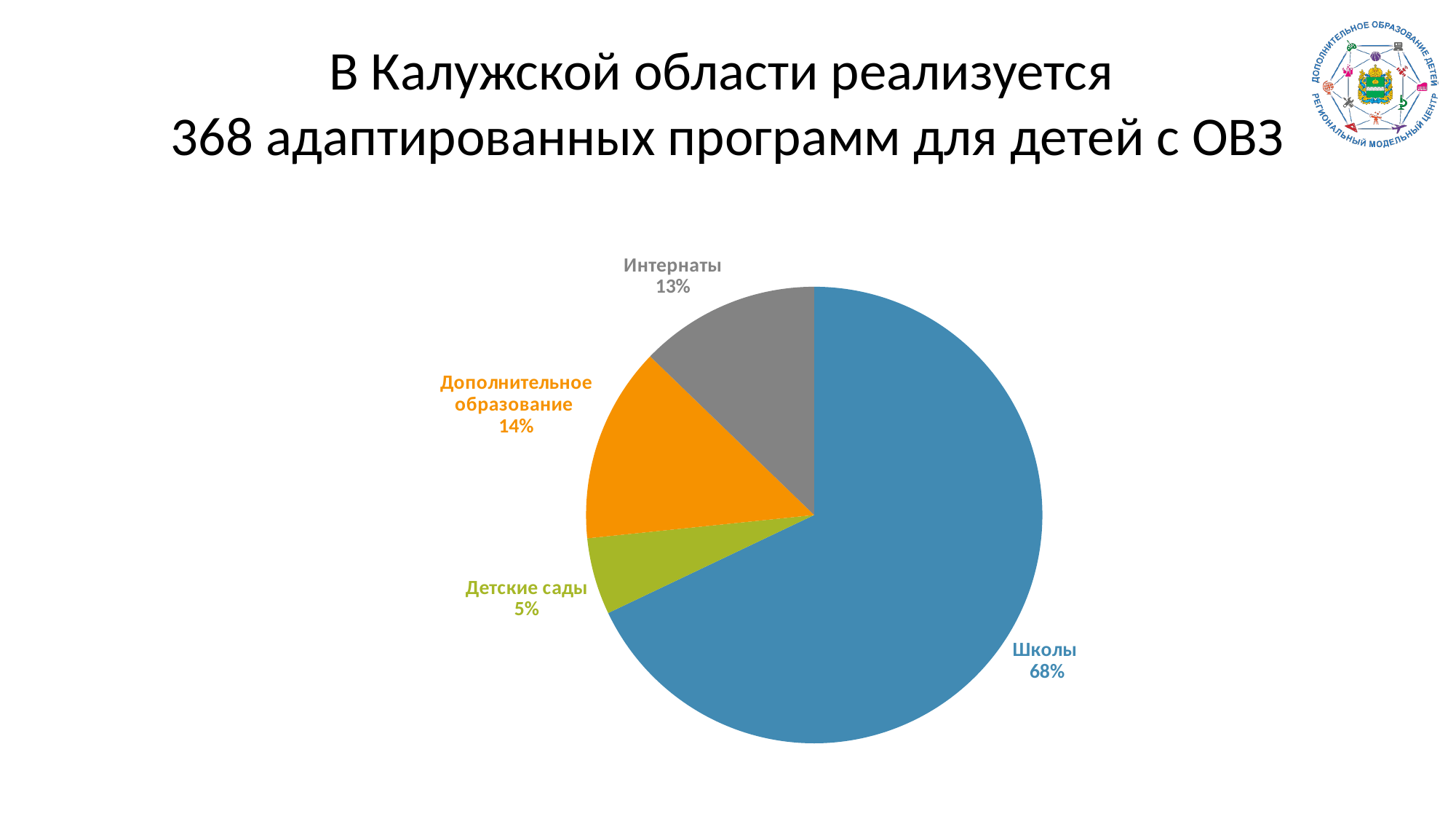
Which category has the smallest slice of the pie? Детские сады What kind of chart is shown on the slide? pie chart What is the difference in percentage points between Школы and Интернаты? 55 How many slices does the pie chart have? 4 What colour is the slice for Школы? blue What share of the pie does Школы have? 68% What share of the pie does Интернаты have? 13% Which is larger, the share for Дополнительное образование or the share for Детские сады? Дополнительное образование What share of the pie does Детские сады have? 5% Which category has the largest slice of the pie? Школы What is the difference in percentage points between Дополнительное образование and Детские сады? 9